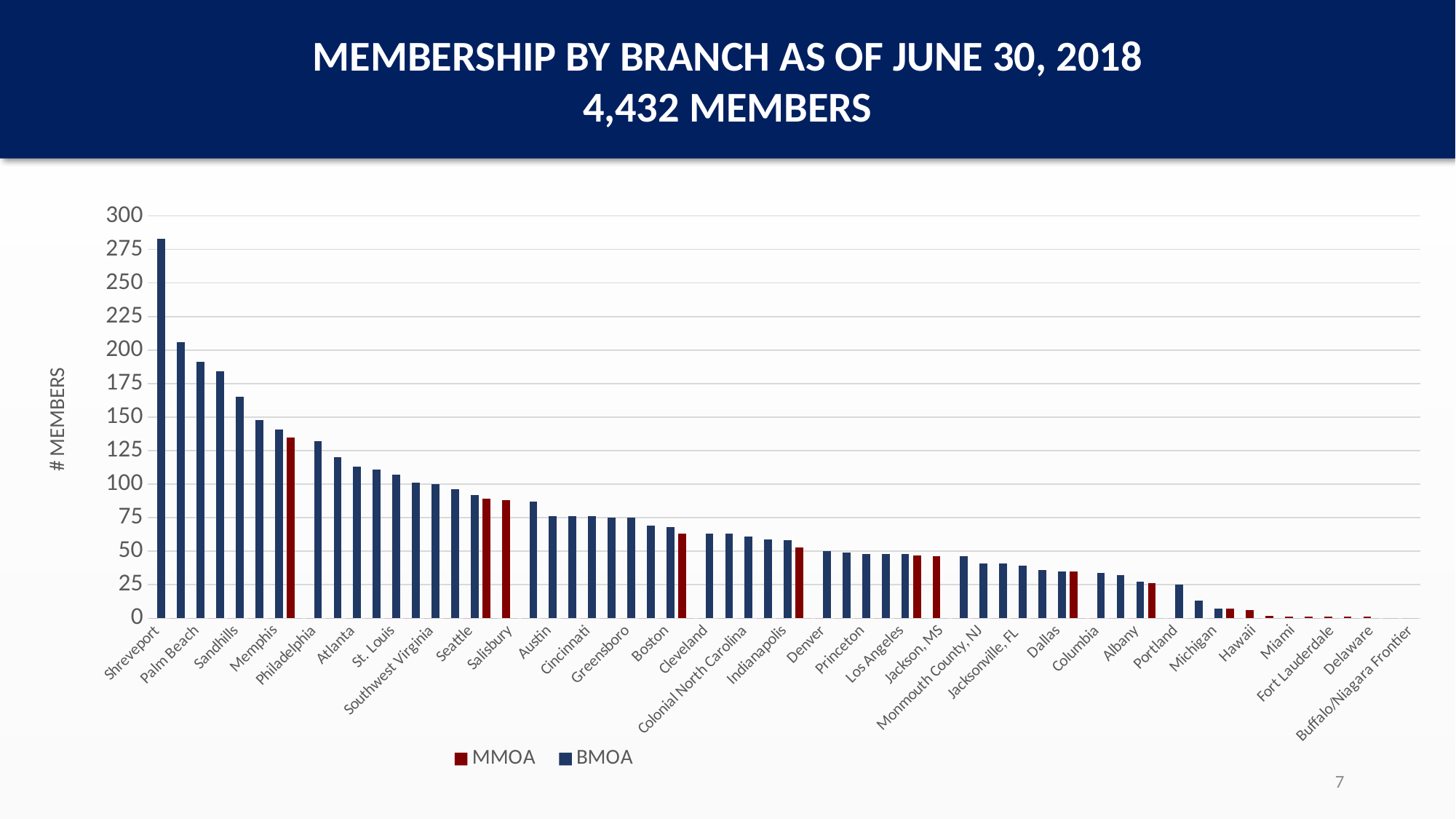
Which has more members, Shreveport or Palm Beach? Shreveport What type of chart is shown on the slide? Bar chart Is the value for Shreveport greater or less than 250? greater How many series does the legend list? 2 What is the title of the chart? MEMBERSHIP BY BRANCH AS OF JUNE 30, 2018 4,432 MEMBERS Which branch has the highest number of members? Shreveport Is the value for Buffalo/Niagara Frontier greater or less than 25? less Which series is shown in red in the legend? MMOA Is the value for Palm Beach greater or less than 150? greater Do the values rise or fall moving from left to right along the x axis? Fall